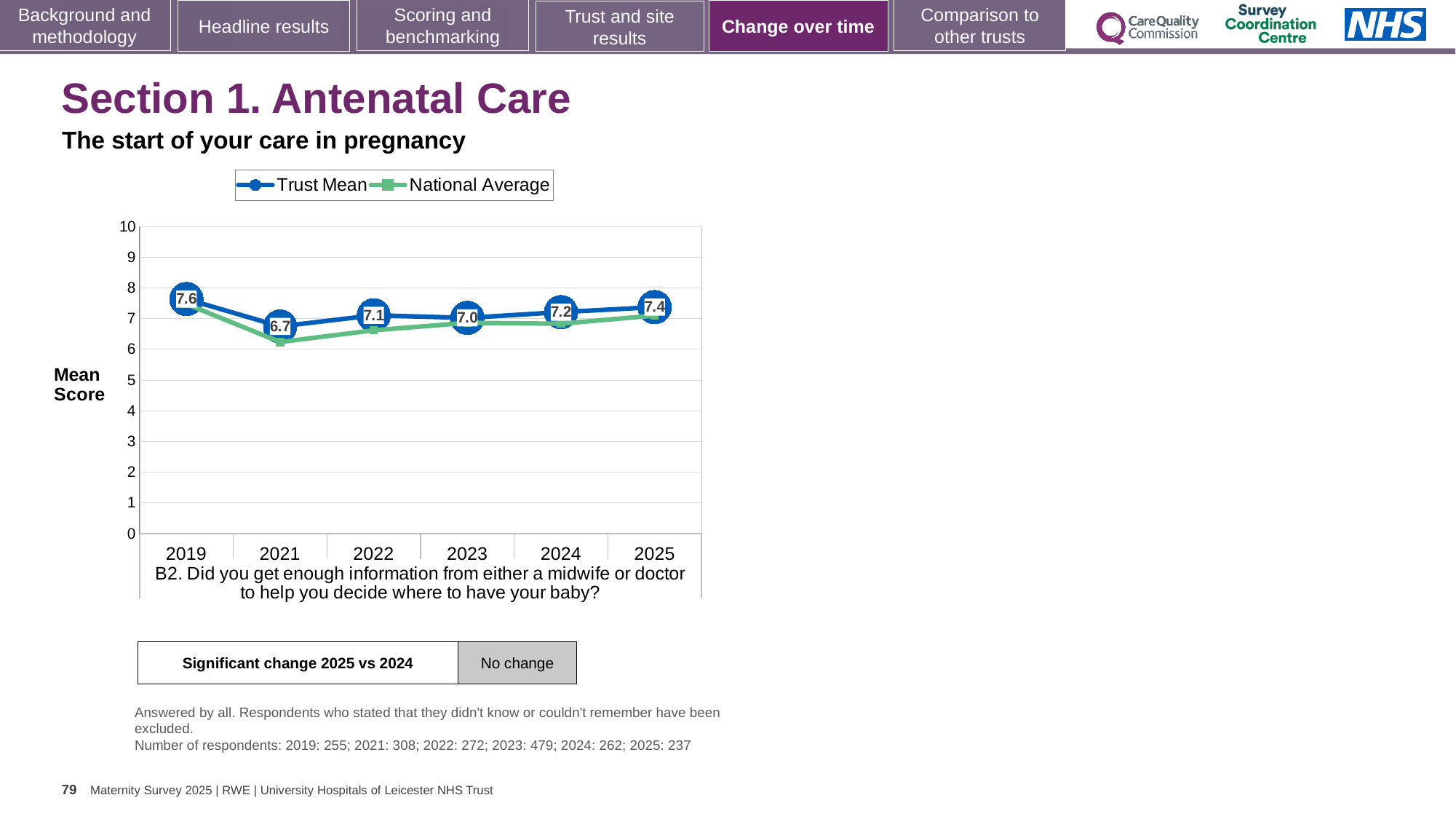
What is the Trust Mean value for 2025? 7.4 Which year has a higher Trust Mean, 2022 or 2024? 2024 What is the difference between the Trust Mean in 2019 and in 2021? 0.9 What kind of chart is shown on the slide? line chart How many series does the legend list? 2 Is the National Average value for 2021 greater or less than 7? less How many years are plotted on the x axis? 6 What is the Trust Mean value for 2023? 7.0 Does the Trust Mean rise or fall from 2021 to 2025? rise In which year is the Trust Mean highest? 2019 What is the Trust Mean value for 2019? 7.6 In which year is the Trust Mean lowest? 2021